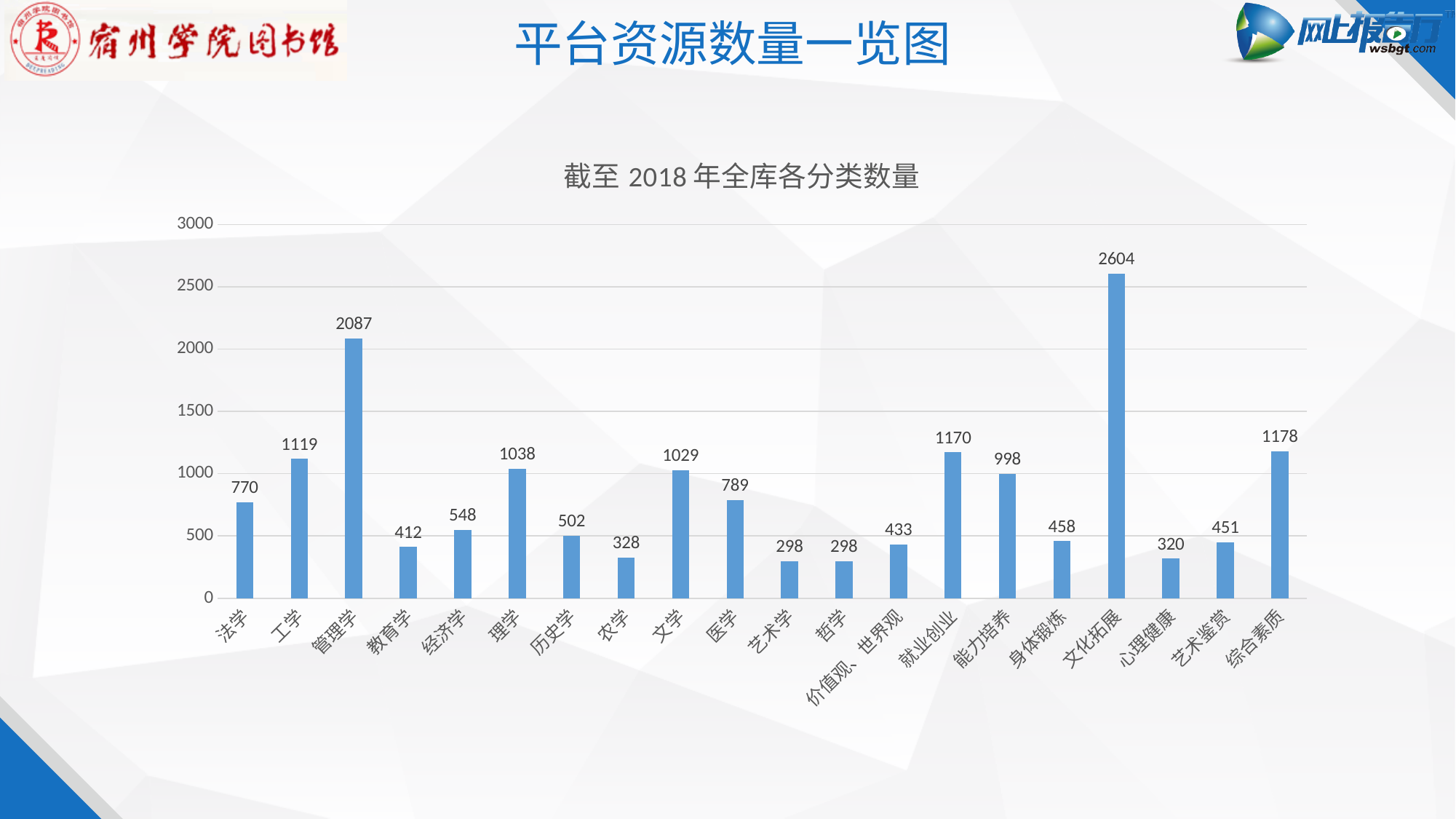
What is the value for 价值观、世界观? 433 What is the title of the chart? 截至 2018 年全库各分类数量 How many categories are shown on the x axis? 20 Is the value for 医学 greater or less than 500? greater What kind of chart is shown on the slide? bar chart What is the value for 管理学? 2087 What is the difference between the values for 工学 and 法学? 349 What is the difference between the values for 文化拓展 and 管理学? 517 Which is larger, the value for 就业创业 or the value for 能力培养? 就业创业 What is the value for 综合素质? 1178 What is the value for 文化拓展? 2604 Which category has the highest value? 文化拓展